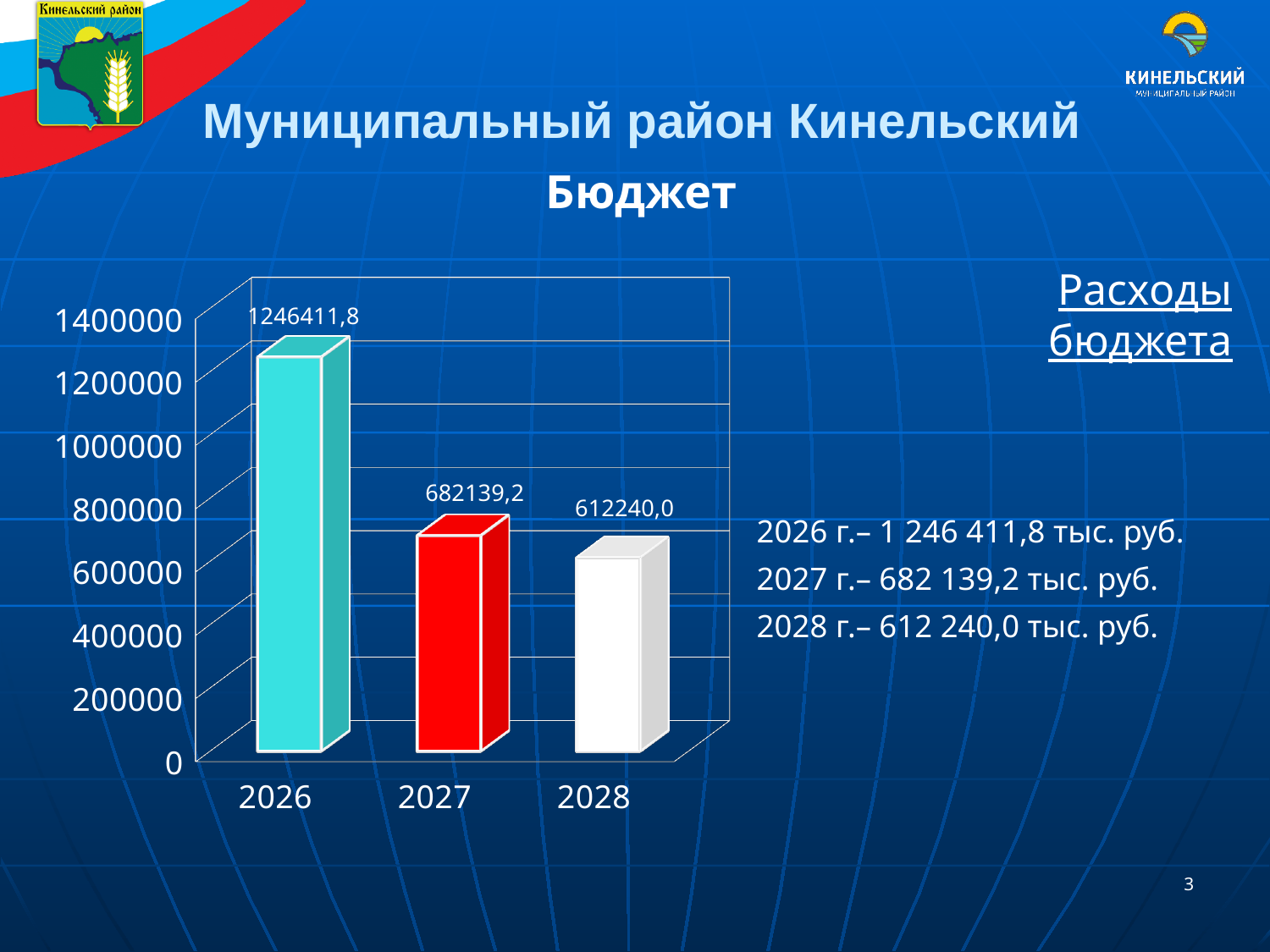
What is the difference between the values for 2027 and 2028? 69899,2 How many years are shown on the x axis of the bar chart? 3 Is the value for 2027 greater or less than 800000? less Which is larger, the value for 2027 or the value for 2028? 2027 What kind of chart is shown on the slide? bar chart Which year has the highest value in the bar chart? 2026 Which year has the lowest value in the bar chart? 2028 What is the difference between the values for 2026 and 2027? 564272,6 What is the value shown for 2027 in the bar chart? 682139,2 What is the value shown for 2026 in the bar chart? 1246411,8 Do the values rise or fall from 2026 to 2028? fall What is the value shown for 2028 in the bar chart? 612240,0